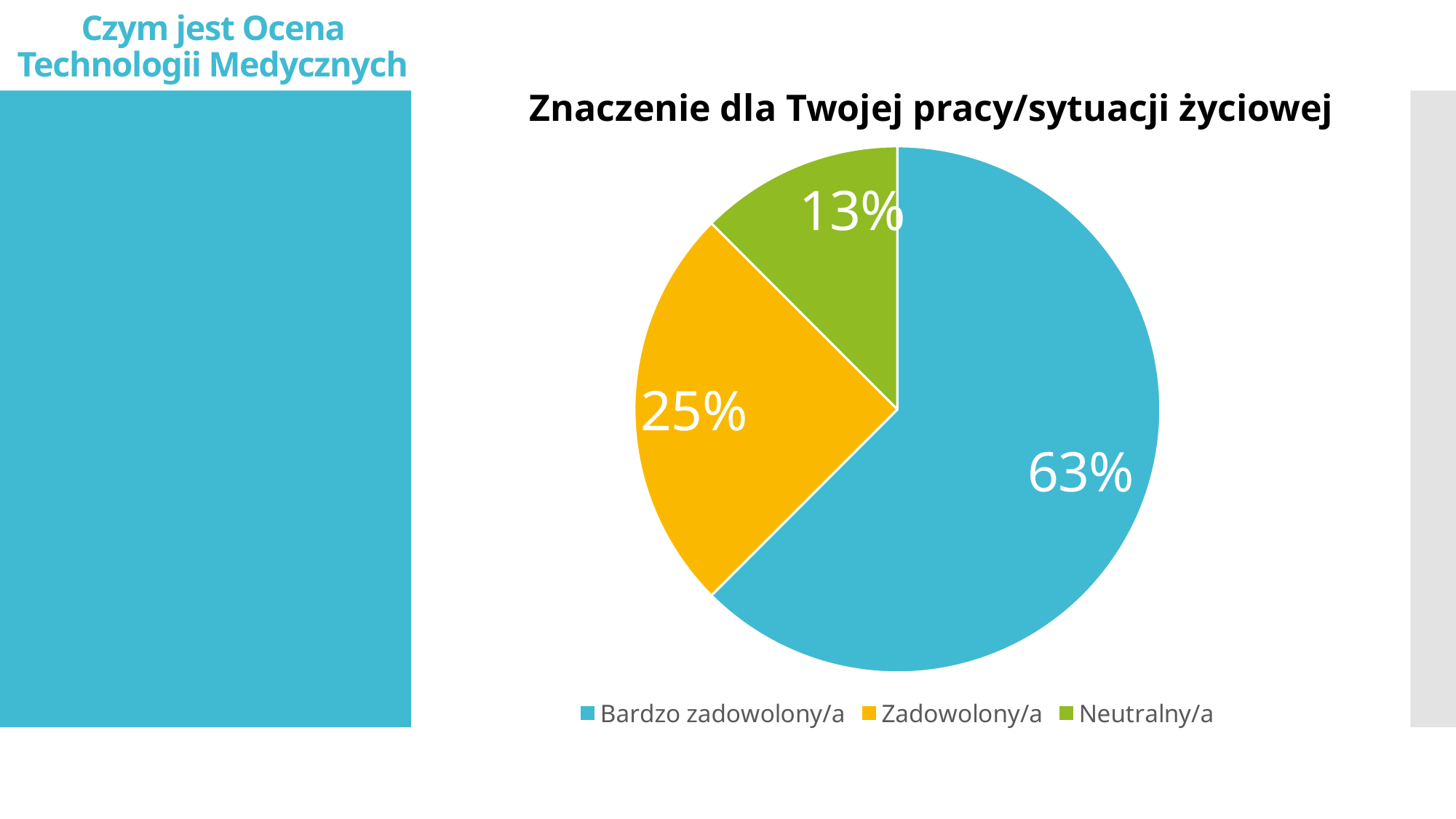
What is the difference in percentage points between Bardzo zadowolony/a and Zadowolony/a? 38 How many categories does the pie chart show? 3 What is the title of the chart? Znaczenie dla Twojej pracy/sytuacji życiowej What share of the pie does Bardzo zadowolony/a have? 63% Which is larger, the slice for Zadowolony/a or the slice for Neutralny/a? Zadowolony/a Which category has the smallest slice of the pie? Neutralny/a What share of the pie does Zadowolony/a have? 25% What kind of chart is shown on the slide? Pie chart Which category has the largest slice of the pie? Bardzo zadowolony/a What colour is the slice for Neutralny/a? Green What share of the pie does Neutralny/a have? 13% What is the difference in percentage points between Zadowolony/a and Neutralny/a? 12